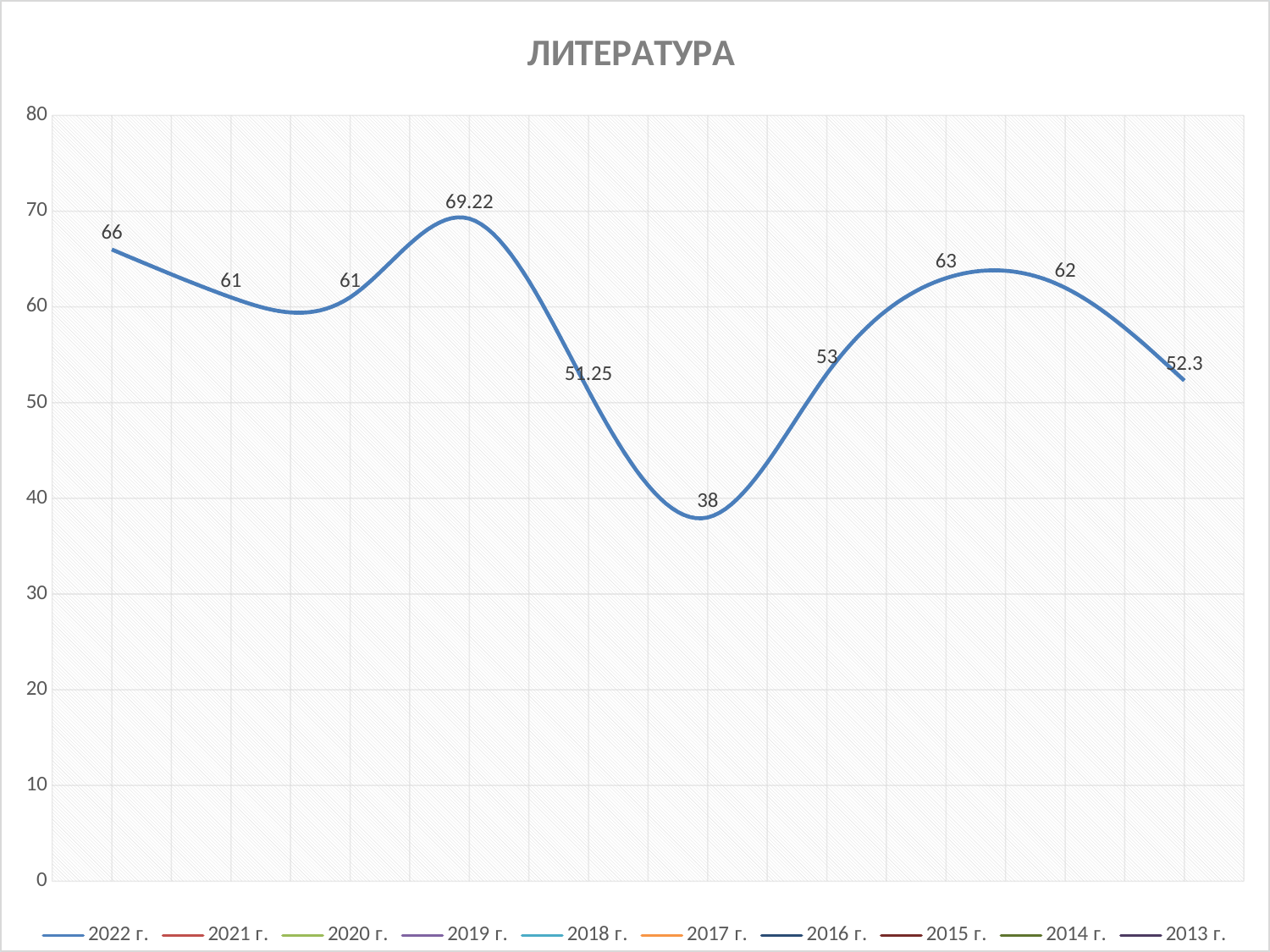
What is the value of the last (rightmost) point on the line? 52.3 Is the lowest point on the line greater or less than 40? less Which is larger, the first point's value (66) or the last point's value (52.3)? 66 Does the line rise or fall between the point labelled 69.22 and the point labelled 38? fall What type of chart is shown on the slide? line chart How many entries does the chart's legend list? 10 What is the difference between the highest labelled value (69.22) and the lowest labelled value (38)? 31.22 What is the highest value labelled on the line? 69.22 How many data points are labelled on the line? 10 What is the title of the chart? ЛИТЕРАТУРА What is the value of the first (leftmost) point on the line? 66 What is the lowest value labelled on the line? 38